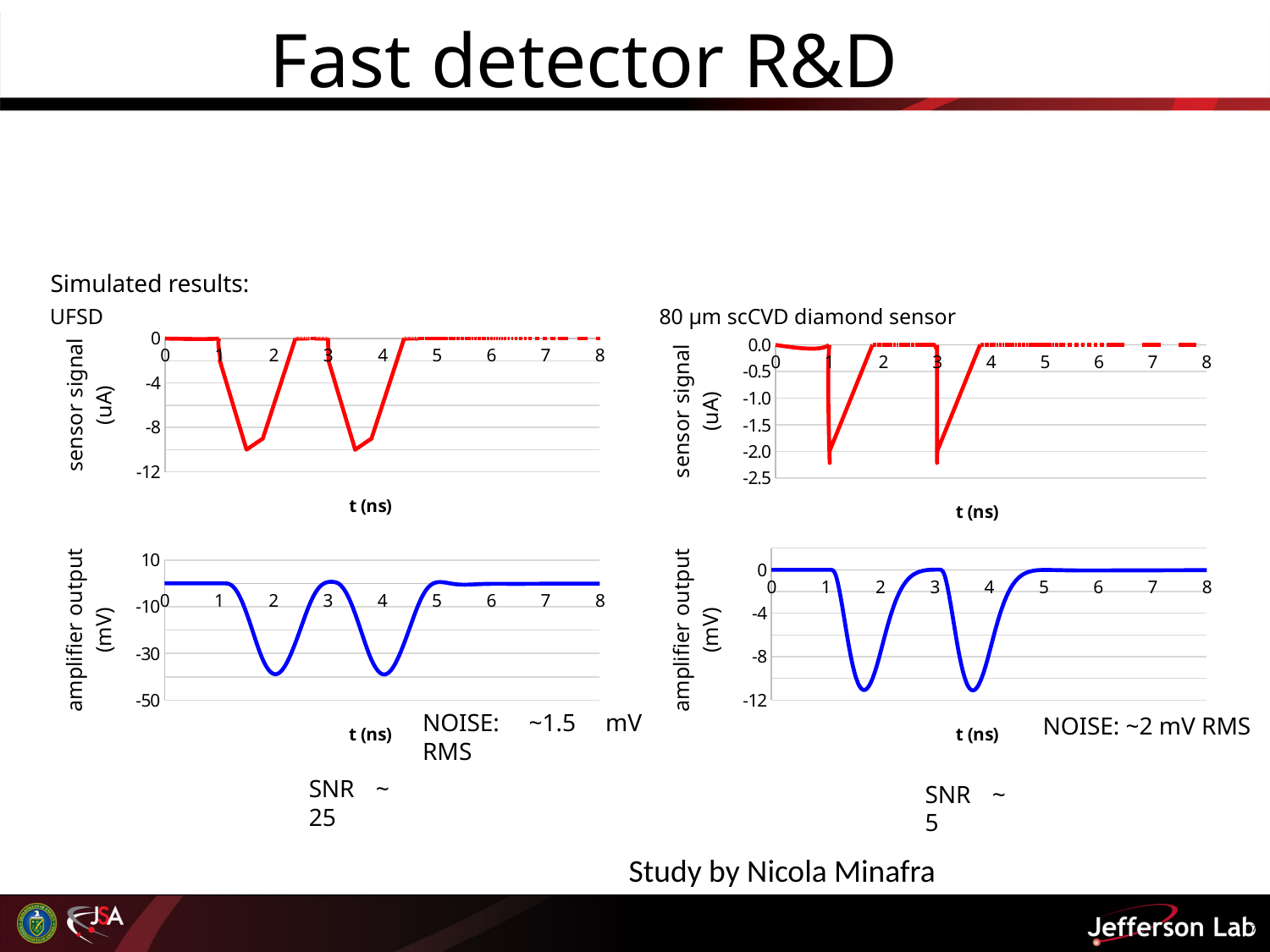
In the UFSD sensor signal chart (top-left), is the lowest value of the signal greater or less than -8? less What is the x-axis label of the UFSD amplifier output chart (bottom-left)? t (ns) In the UFSD sensor signal chart (top-left), do the values rise or fall between t = 1 ns and t = 1.5 ns? fall What colour is the line in the 80 µm scCVD diamond amplifier output chart (bottom-right)? blue How many pulses (dips) does the UFSD sensor signal chart (top-left) show? 2 In the UFSD amplifier output chart (bottom-left), is the lowest value of the output greater or less than -30? less In the 80 µm scCVD diamond sensor signal chart (top-right), is the value at t = 5 ns greater or less than -0.5? greater What kind of chart is the UFSD sensor signal chart (top-left)? line chart Which amplifier output chart shows the larger peak magnitude, the UFSD chart (bottom-left) or the 80 µm scCVD diamond sensor chart (bottom-right)? UFSD